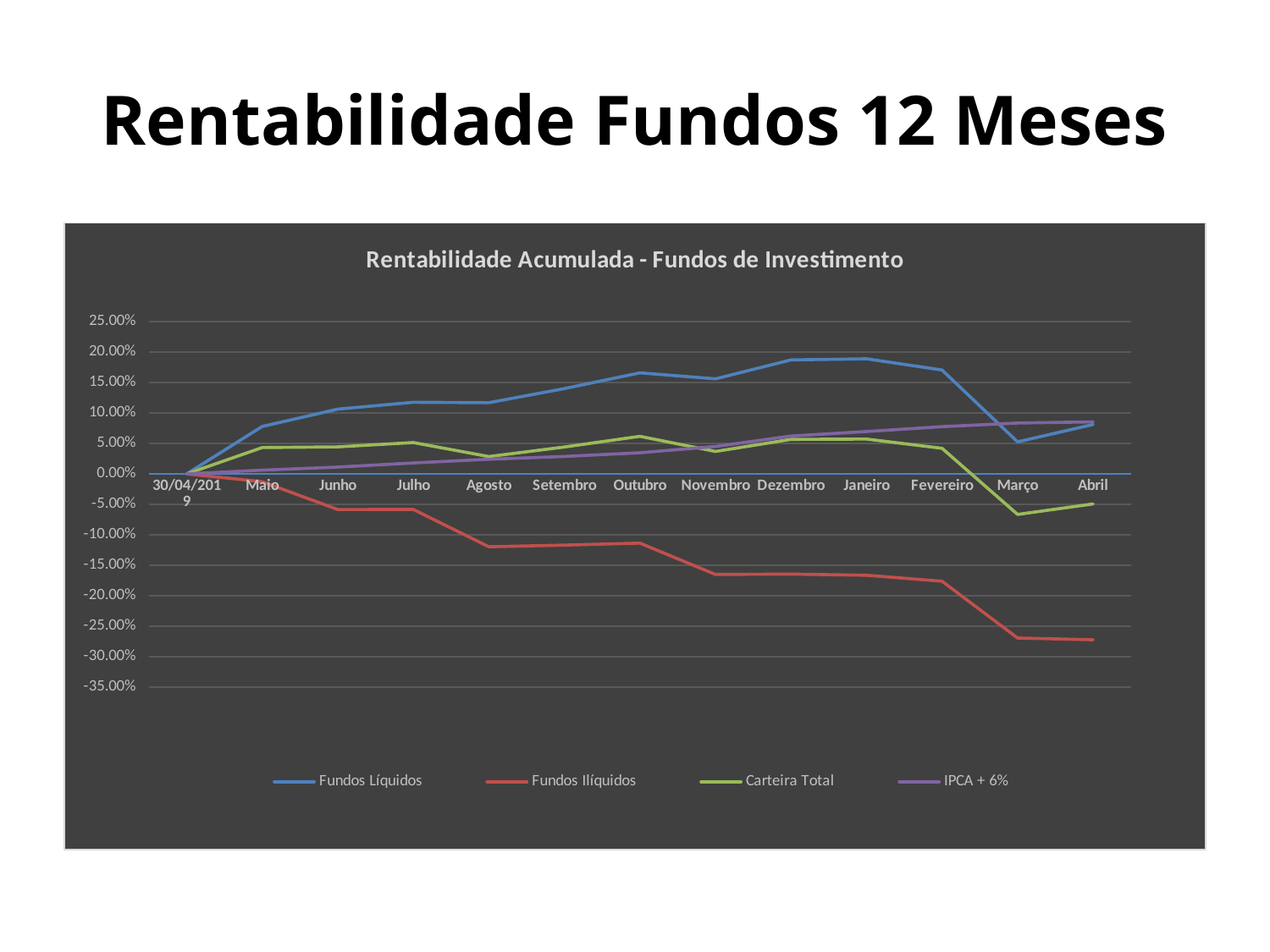
Does the Fundos Ilíquidos line rise or fall from 30/04/2019 to Abril? fall In Março, which is higher: Fundos Líquidos or IPCA + 6%? IPCA + 6% Which series has the highest value in Janeiro? Fundos Líquidos How many series does the legend list? 4 How many points are there along the x axis? 13 Which series has the lowest value in Março? Fundos Ilíquidos Is the value for Fundos Ilíquidos in Abril greater or less than -25.00%? less What kind of chart is shown on the slide? line chart Is the value for Fundos Líquidos in Janeiro greater or less than 15.00%? greater Is the value for Carteira Total in Março greater or less than 0.00%? less What is the title of the chart? Rentabilidade Acumulada - Fundos de Investimento